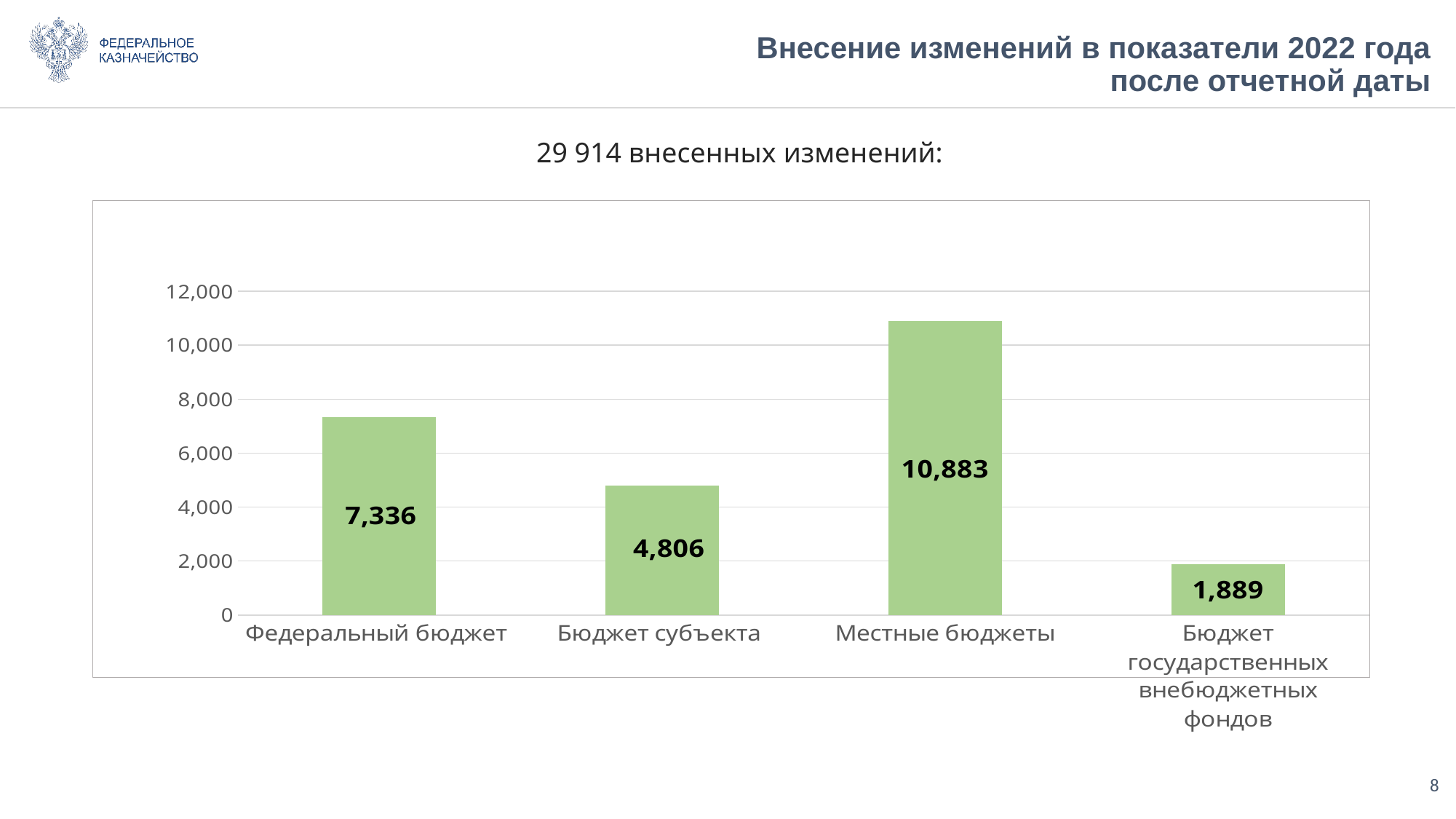
What is the difference between the values for Бюджет субъекта and Бюджет государственных внебюджетных фондов? 2,917 What is the value for Бюджет субъекта? 4,806 What is the difference between the values for Местные бюджеты and Федеральный бюджет? 3,547 What is the value for Местные бюджеты? 10,883 How many categories are shown in the chart? 4 What kind of chart is shown on the slide? bar chart Is the value for Местные бюджеты greater or less than 10,000? greater Which category has the highest value? Местные бюджеты Which is larger, the value for Федеральный бюджет or the value for Бюджет субъекта? Федеральный бюджет Which category has the lowest value? Бюджет государственных внебюджетных фондов What is the value for Бюджет государственных внебюджетных фондов? 1,889 What is the value for Федеральный бюджет? 7,336